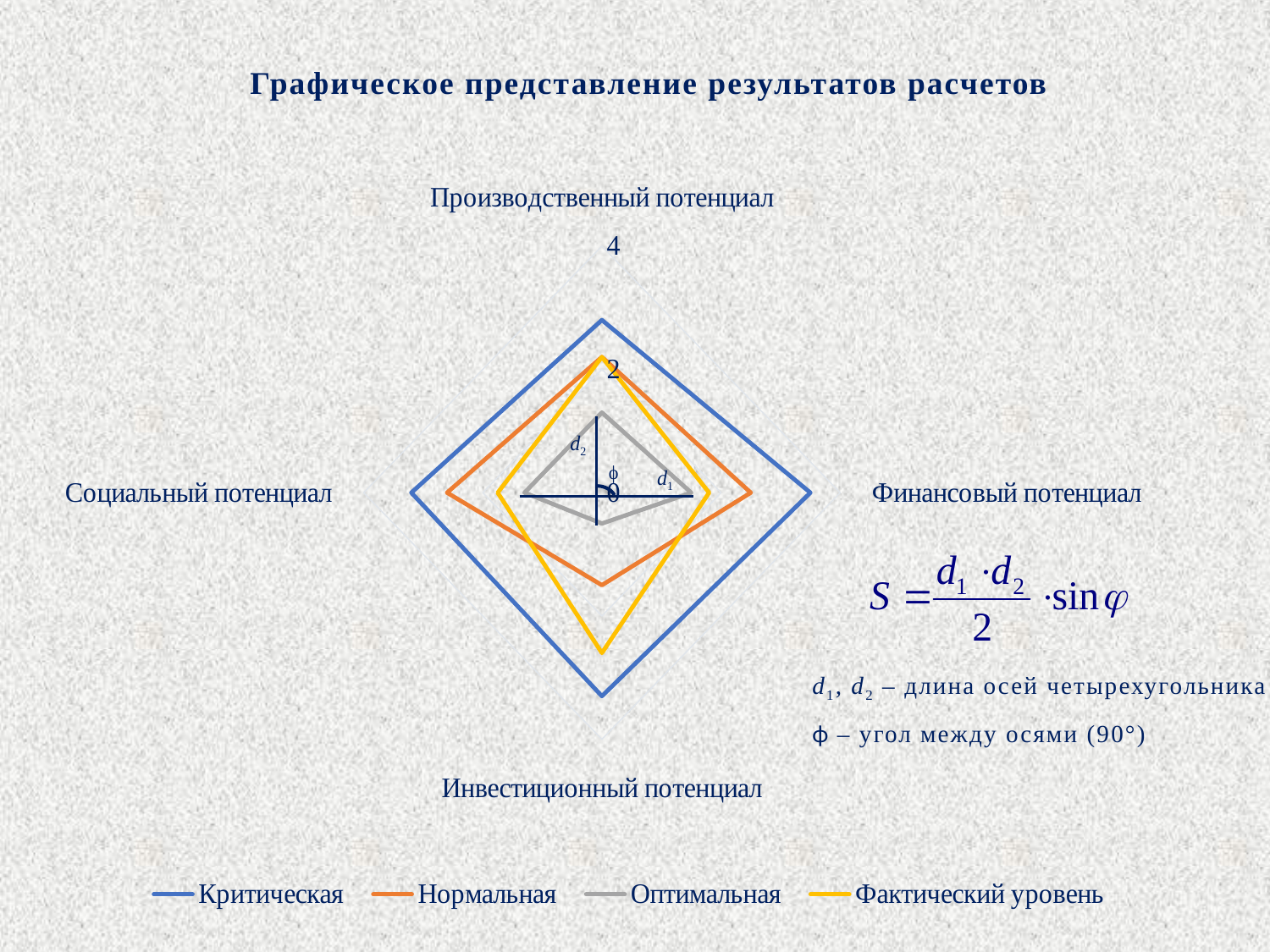
What is the title of the slide containing the chart? Графическое представление результатов расчетов Is the value of Оптимальная on the Инвестиционный потенциал axis greater or less than 2? less How many axes (categories) does the radar chart have? 4 Which series is drawn in yellow in the legend? Фактический уровень What kind of chart is shown on the slide? radar chart How many series does the legend list? 4 Is the value of Нормальная on the Инвестиционный потенциал axis greater or less than 2? less Is the value of Критическая on the Производственный потенциал axis greater or less than 2? greater On the Социальный потенциал axis, which is larger: Нормальная or Фактический уровень? Нормальная Which series forms the innermost diamond on the chart? Оптимальная Which series forms the outermost diamond on the chart? Критическая On the Инвестиционный потенциал axis, which is larger: Фактический уровень or Нормальная? Фактический уровень